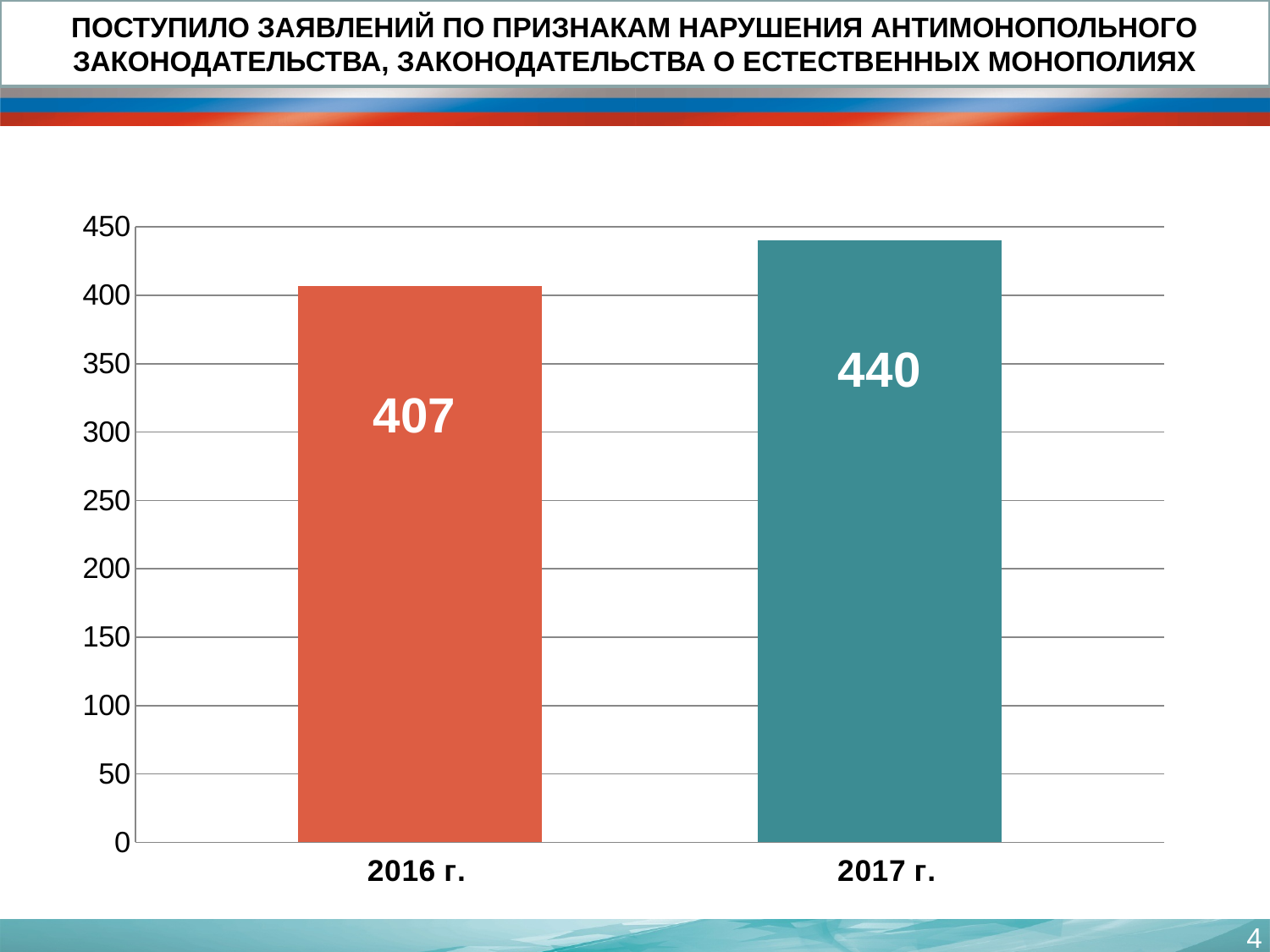
Is the value for 2017 г. greater or less than 450? less What is the difference between the values for 2017 г. and 2016 г.? 33 Which is larger, the value for 2016 г. or the value for 2017 г.? 2017 г. Which year has the lowest value? 2016 г. What is the value for 2016 г.? 407 Is the value for 2016 г. greater or less than 400? greater Which year has the highest value? 2017 г. Do the values rise or fall from 2016 г. to 2017 г.? rise How many categories are shown on the x axis? 2 What is the value for 2017 г.? 440 What kind of chart is shown on the slide? bar chart What is the maximum value shown on the vertical axis? 450